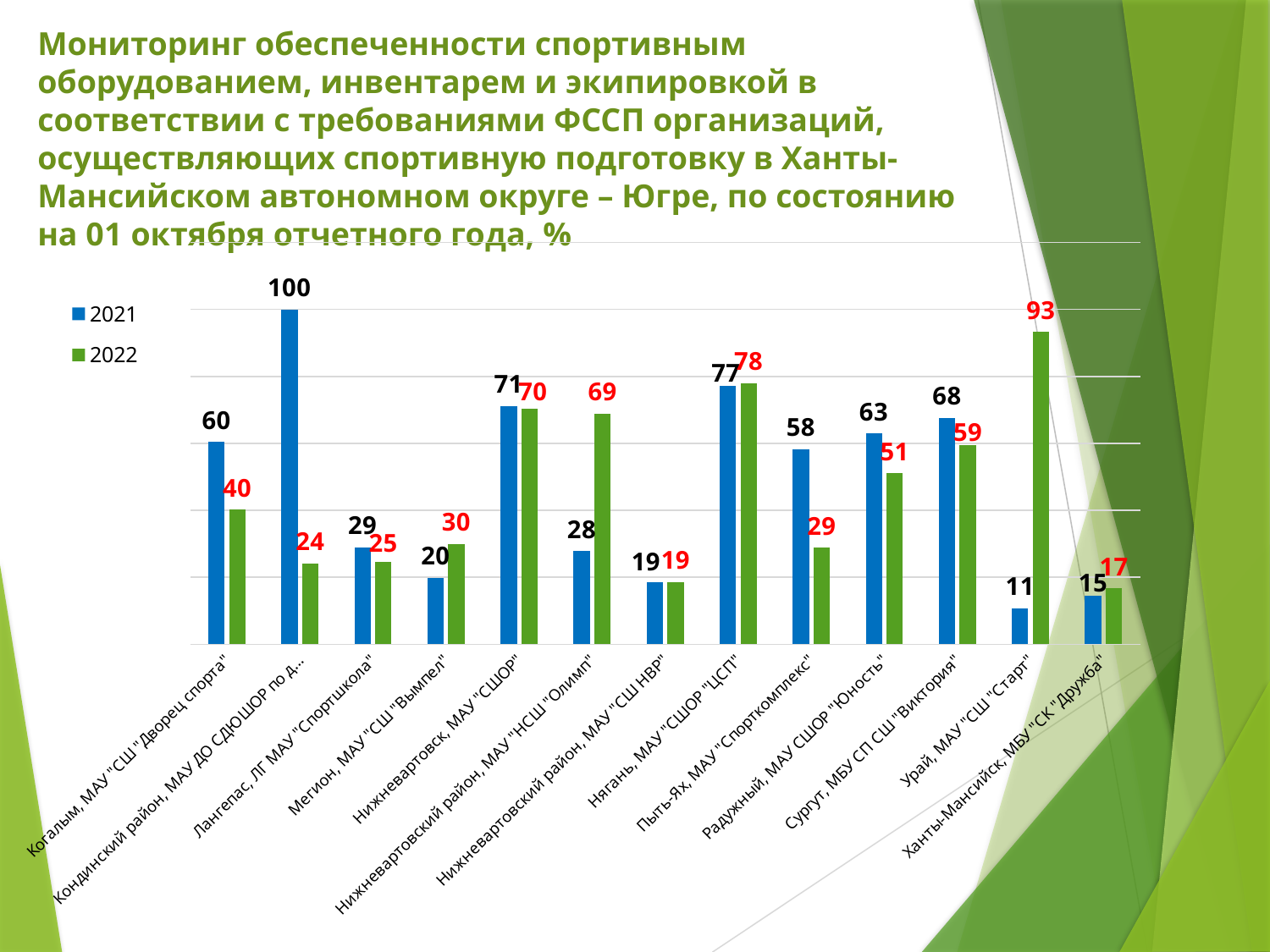
What is the difference between the 2021 and 2022 values for Кондинский район, МАУ ДО СДЮШОР по д...? 76 How many series does the legend list? 2 Which organisation has the highest 2022 value? Урай, МАУ "СШ "Старт" What is the 2021 value for Когалым, МАУ "СШ "Дворец спорта"? 60 For Радужный, МАУ СШОР "Юность", which year has the larger value, 2021 or 2022? 2021 How many organisations are shown on the x axis? 13 Which organisation has the lowest 2021 value? Урай, МАУ "СШ "Старт" What is the 2022 value for Урай, МАУ "СШ "Старт"? 93 What kind of chart is shown on the slide? Bar chart What is the difference between the 2021 and 2022 values for Пыть-Ях, МАУ "Спорткомплекс"? 29 What is the 2022 value for Нижневартовский район, МАУ "НСШ "Олимп"? 69 Which organisation has the highest 2021 value? Кондинский район, МАУ ДО СДЮШОР по д...